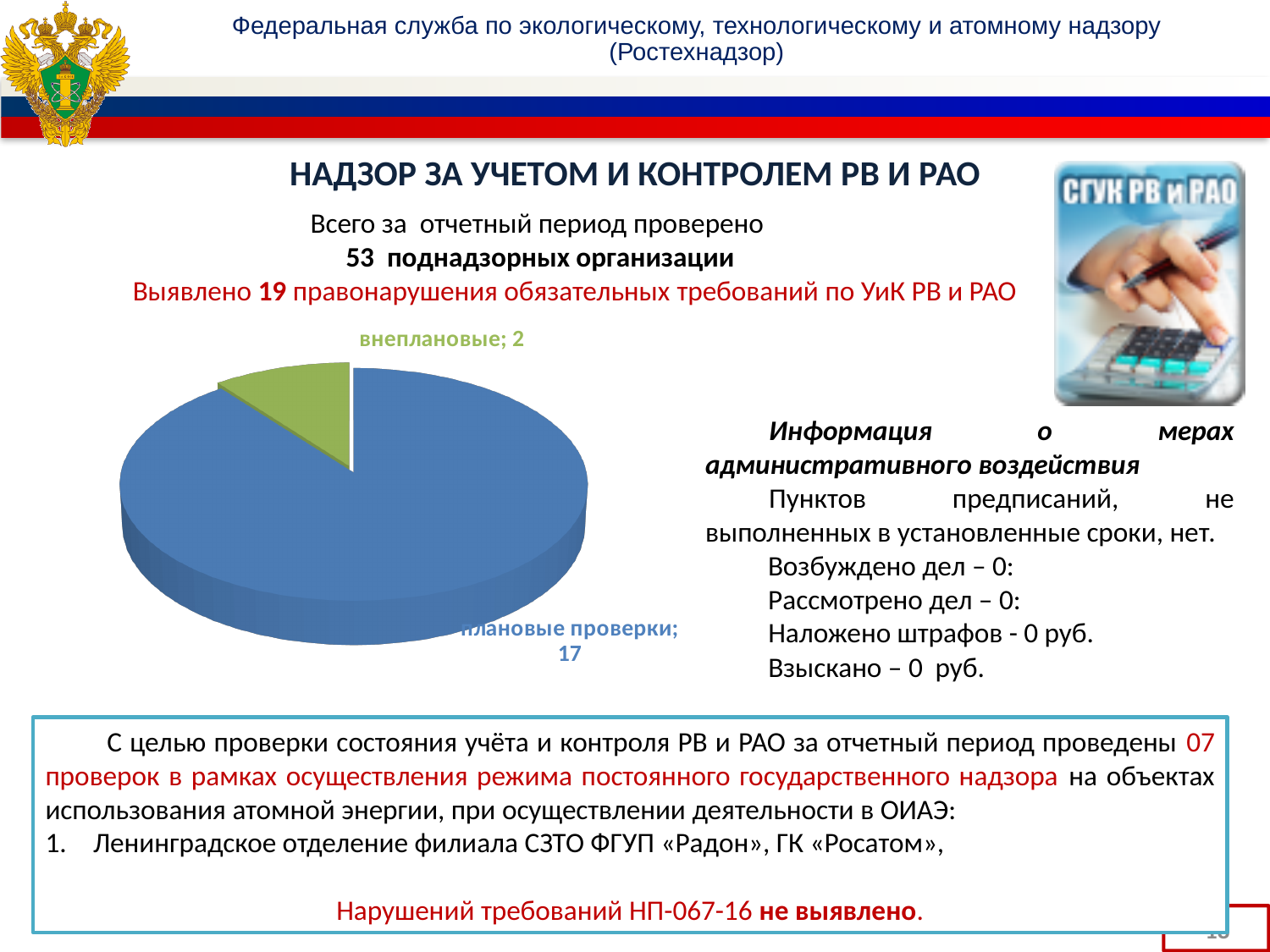
What type of chart is shown on the slide? pie chart What share of the pie chart's total do the внеплановые checks represent? 2 out of 19 What value is shown for the "плановые проверки" slice of the pie chart? 17 What value is shown for the "внеплановые" slice of the pie chart? 2 What colour is the "плановые проверки" slice of the pie chart? blue By how much does the number of плановые проверки exceed the number of внеплановые in the pie chart? 15 Which slice of the pie chart is the smallest? внеплановые What is the total of the two values shown in the pie chart? 19 What colour is the "внеплановые" slice of the pie chart? green Which is larger in the pie chart: плановые проверки or внеплановые? плановые проверки How many slices does the pie chart have? 2 Which slice of the pie chart is the largest? плановые проверки